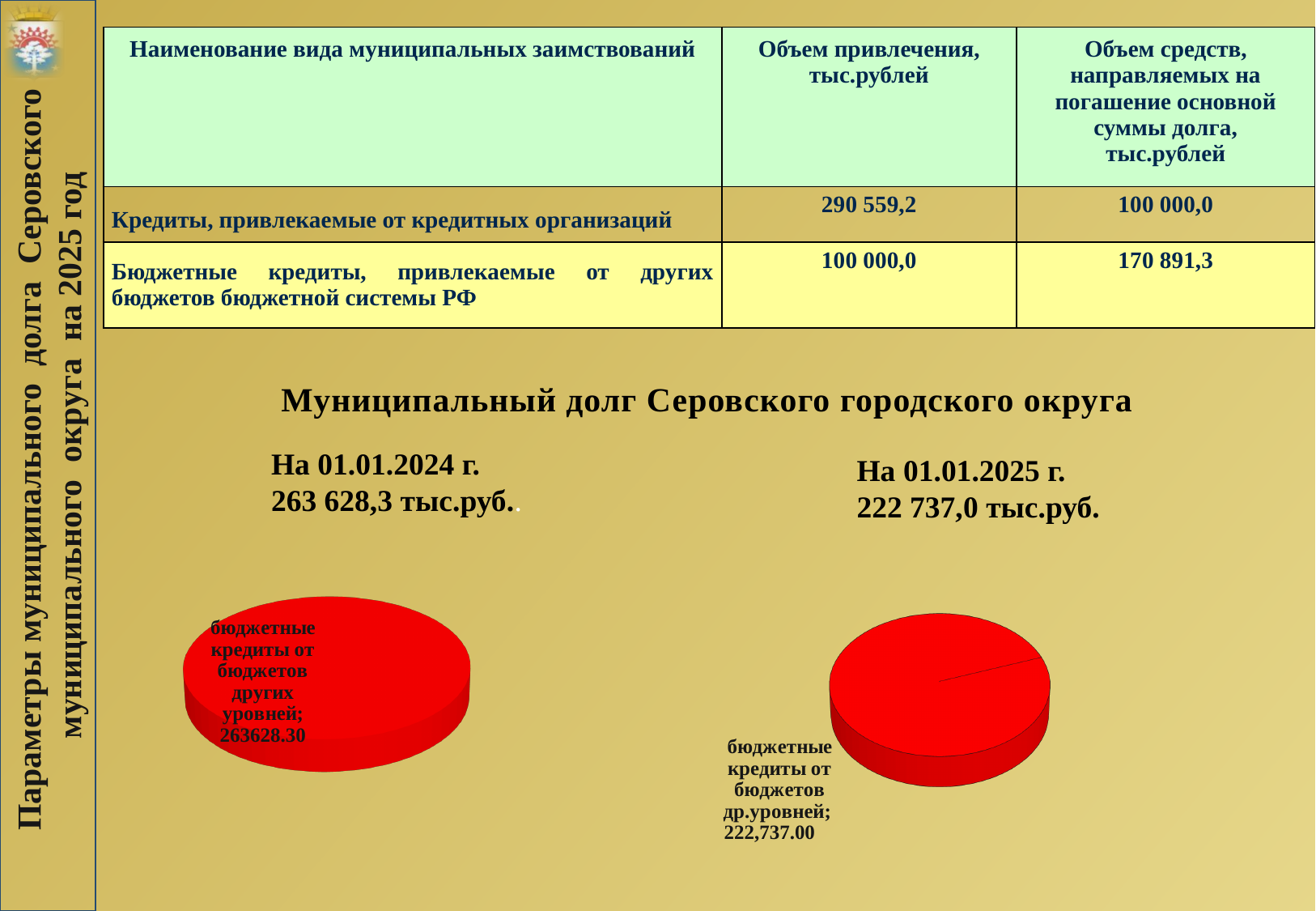
How many slices does the right pie chart (На 01.01.2025 г.) have? 1 What is the label of the only slice in the right pie chart (На 01.01.2025 г.)? бюджетные кредиты от бюджетов др.уровней In the left pie chart (На 01.01.2024 г.), what value is shown for 'бюджетные кредиты от бюджетов других уровней'? 263628.30 Which is larger: the value in the left pie chart (263628.30) or the value in the right pie chart (222,737.00)? the left pie chart (263628.30) In the left pie chart (На 01.01.2024 г.), what share of the pie does the 'бюджетные кредиты от бюджетов других уровней' slice take? 100% What kind of chart is the left chart under 'На 01.01.2024 г.'? pie chart In the right pie chart (На 01.01.2025 г.), what value is shown for 'бюджетные кредиты от бюджетов др.уровней'? 222,737.00 What kind of chart is the right chart under 'На 01.01.2025 г.'? pie chart In the right pie chart (На 01.01.2025 г.), what share of the pie does the 'бюджетные кредиты от бюджетов др.уровней' slice take? 100% What colour is the slice in the left pie chart (На 01.01.2024 г.)? red How many slices does the left pie chart (На 01.01.2024 г.) have? 1